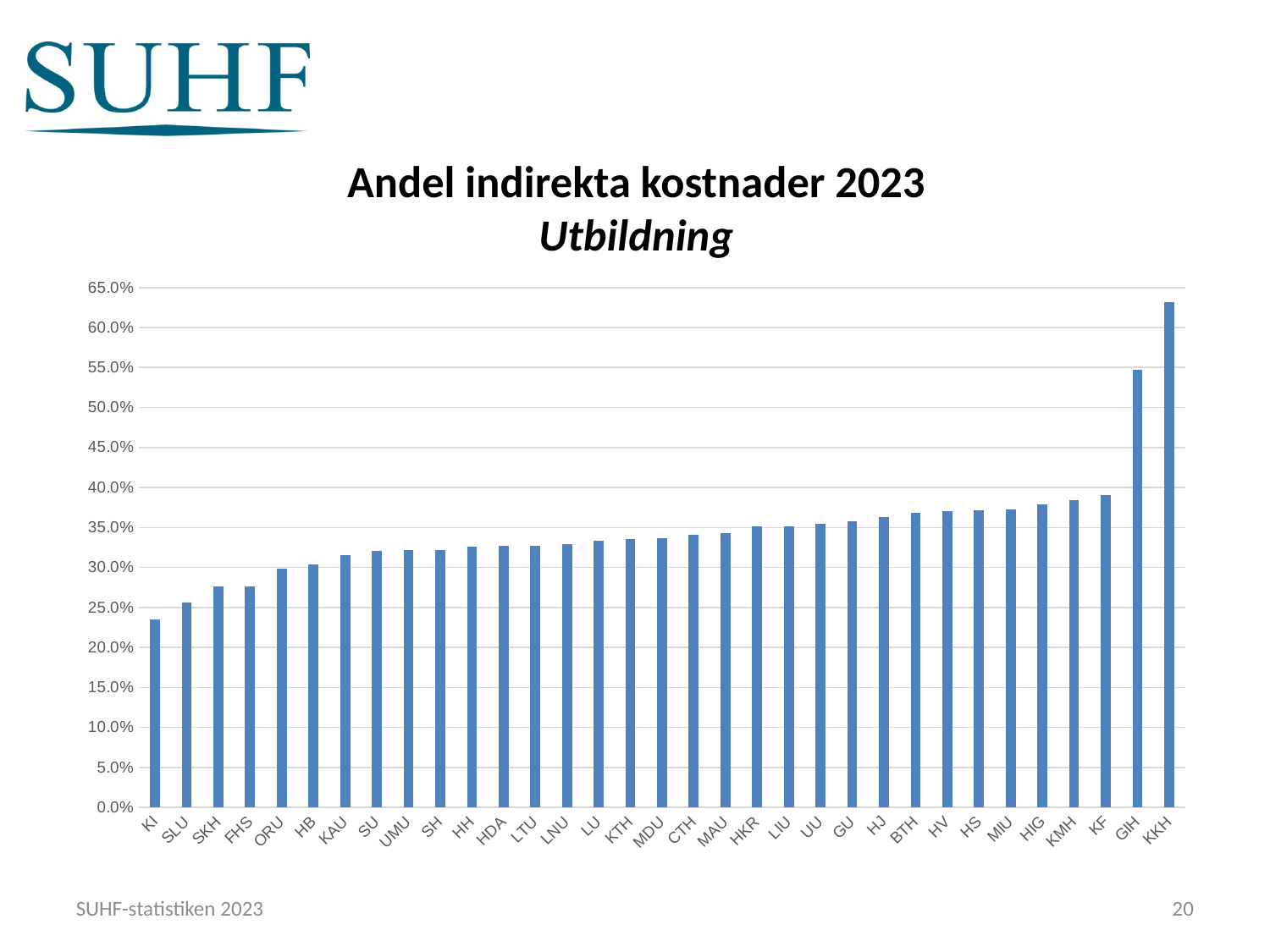
Is the value for GIH greater or less than 50.0%? greater Which category has the highest value in the chart? KKH Is the value for KKH greater or less than 60.0%? greater What is the title of the chart? Andel indirekta kostnader 2023 Utbildning Is the value for KI greater or less than 25.0%? less Which category has the lowest value in the chart? KI What kind of chart is shown on the slide? bar chart Which has the larger value, GIH or KF? GIH How many categories are shown on the x axis of the chart? 33 Do the values generally rise or fall from left to right along the x axis? rise